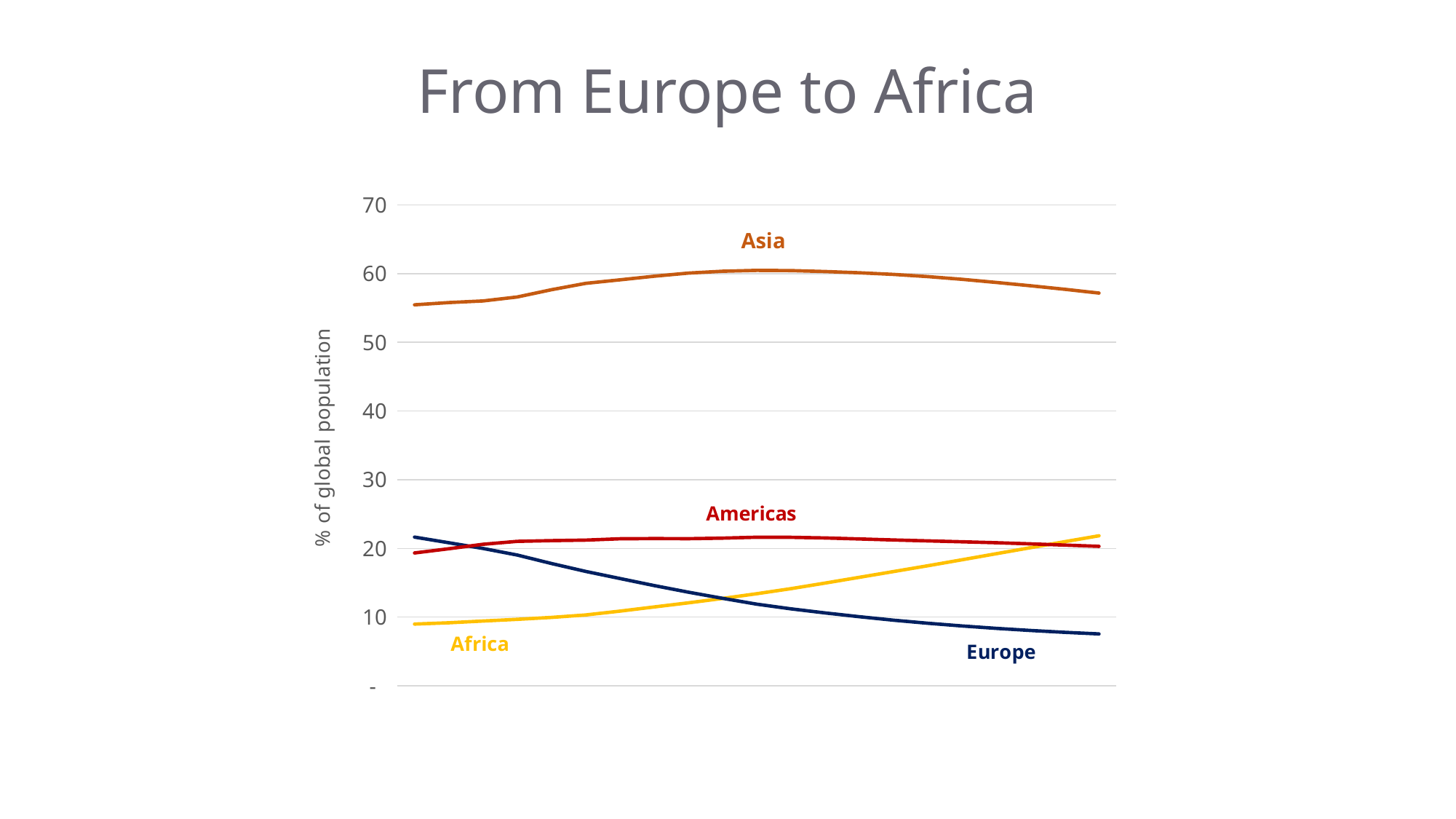
What is the title of the slide? From Europe to Africa What kind of chart is shown on the slide? line chart At the right end of the chart, which is larger: Africa or Europe? Africa What is the title of the chart's vertical axis? % of global population Is the value for Europe at the right end of the chart greater or less than 10? less How many series (lines) are labelled on the chart? 4 Which series has the lowest value at the right end of the chart? Europe Does the Europe line rise or fall from left to right? fall Is the value for Asia at the left end of the chart greater or less than 50? greater Does the Africa line rise or fall from left to right? rise Which series has the highest values throughout the chart? Asia At the left end of the chart, which is larger: Europe or Africa? Europe